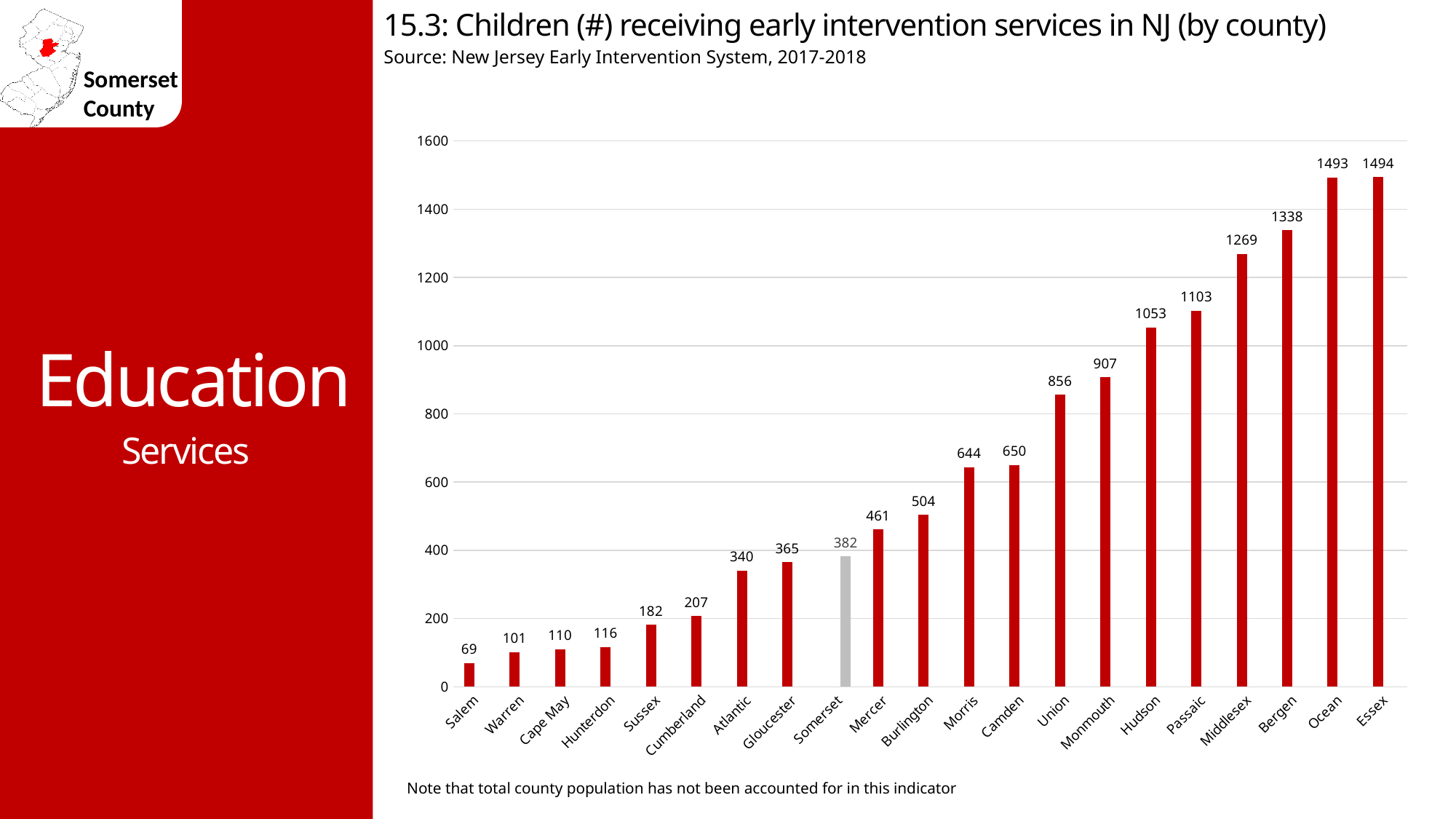
What kind of chart is shown on the slide? Bar chart Which county has a larger value, Union or Monmouth? Monmouth Is the value for Passaic greater or less than 1000? greater How many counties are shown on the chart? 21 Do the values rise or fall moving from left to right along the x axis? Rise What is the difference between the values for Bergen and Middlesex? 69 Which county has the lowest number of children receiving early intervention services? Salem Which county's bar is shown in grey rather than red? Somerset What is the difference between the values for Essex and Somerset? 1112 What is the value shown for Hudson County? 1053 What is the value shown for Cape May? 110 How many children received early intervention services in Somerset County? 382